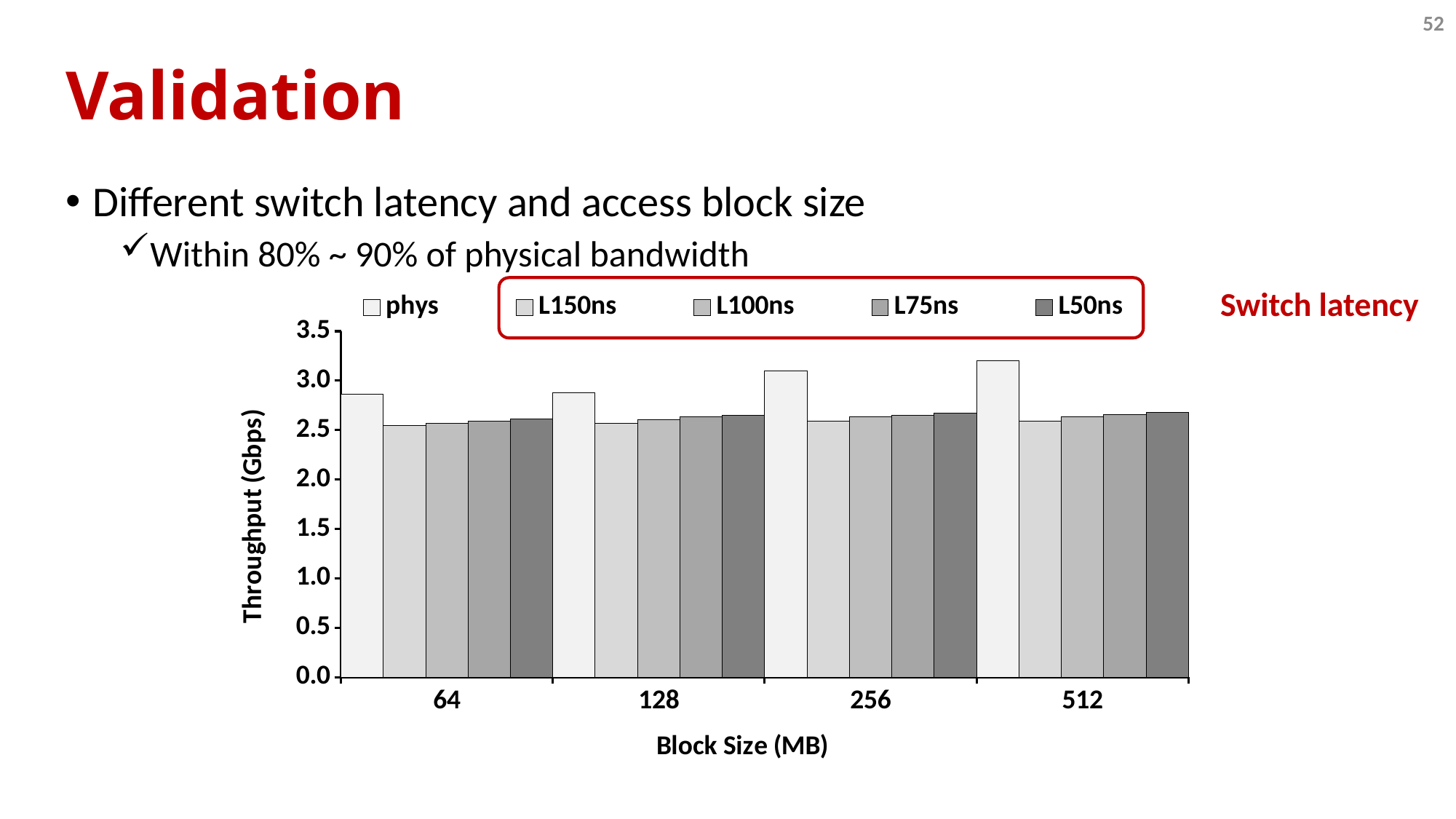
At which block size is the phys throughput highest? 512 How many series does the legend list? 5 Is the L150ns throughput at block size 64 greater or less than 2.0? greater Is the phys throughput at block size 512 greater or less than 3.0? greater Is the phys throughput at block size 64 greater or less than 3.0? less What is the label of the y axis? Throughput (Gbps) At block size 256, which is larger: the phys throughput or the L50ns throughput? phys What kind of chart is shown on the slide? bar chart Does the phys throughput rise or fall as block size increases from 64 to 512? rise What is the label of the x axis? Block Size (MB) How many block sizes are shown on the x axis? 4